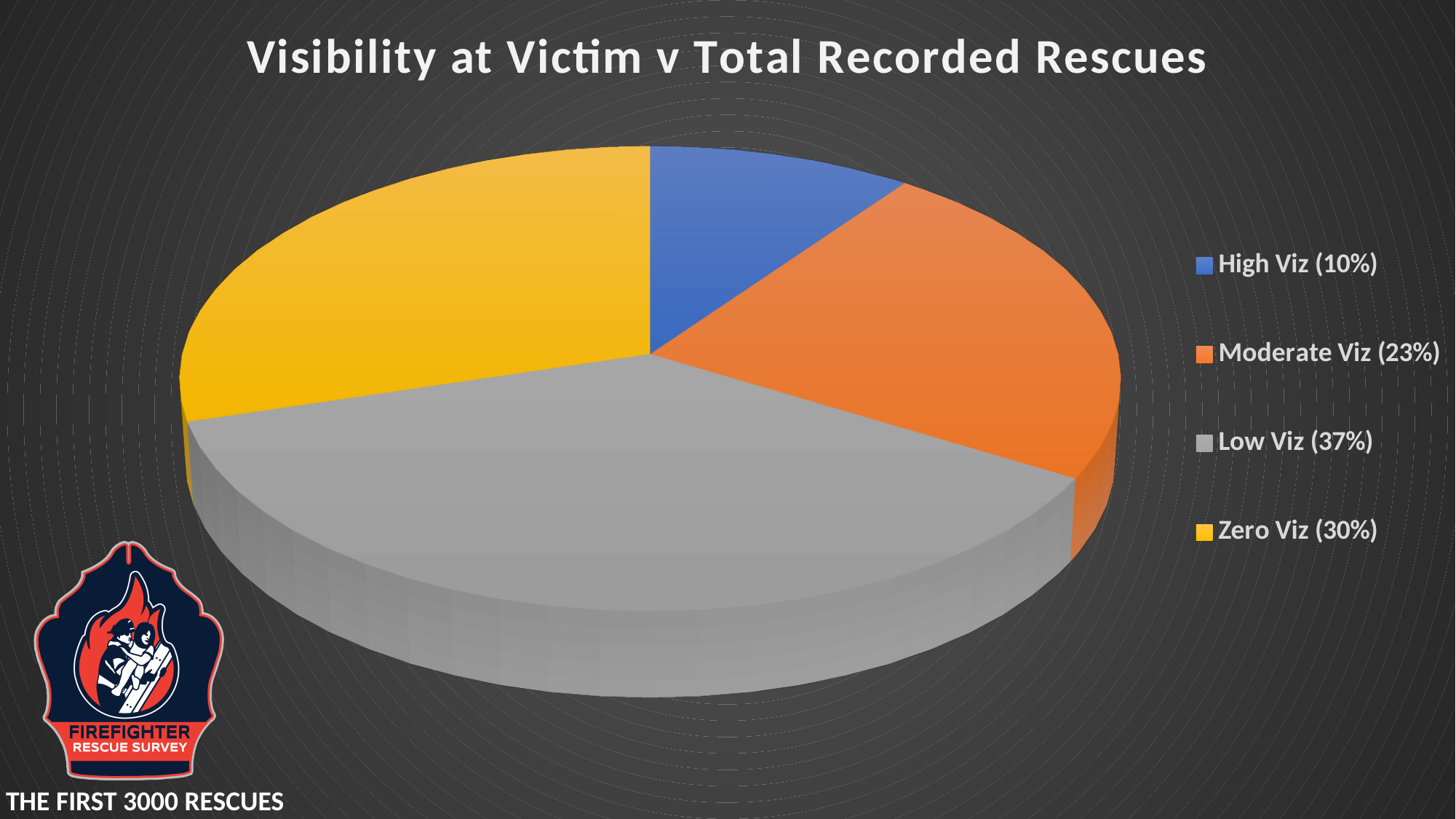
What colour is the Zero Viz slice? Yellow What kind of chart is shown on the slide? Pie chart What is the difference in percentage points between Low Viz and Zero Viz? 7 What share of rescues is shown for Zero Viz? 30% What is the title of the chart? Visibility at Victim v Total Recorded Rescues What share of rescues is shown for Moderate Viz? 23% How many categories does the pie chart show? 4 What share of rescues is shown for High Viz? 10% Which visibility category has the largest share of rescues? Low Viz Which is larger, the share for Moderate Viz or the share for Zero Viz? Zero Viz Which visibility category has the smallest share of rescues? High Viz